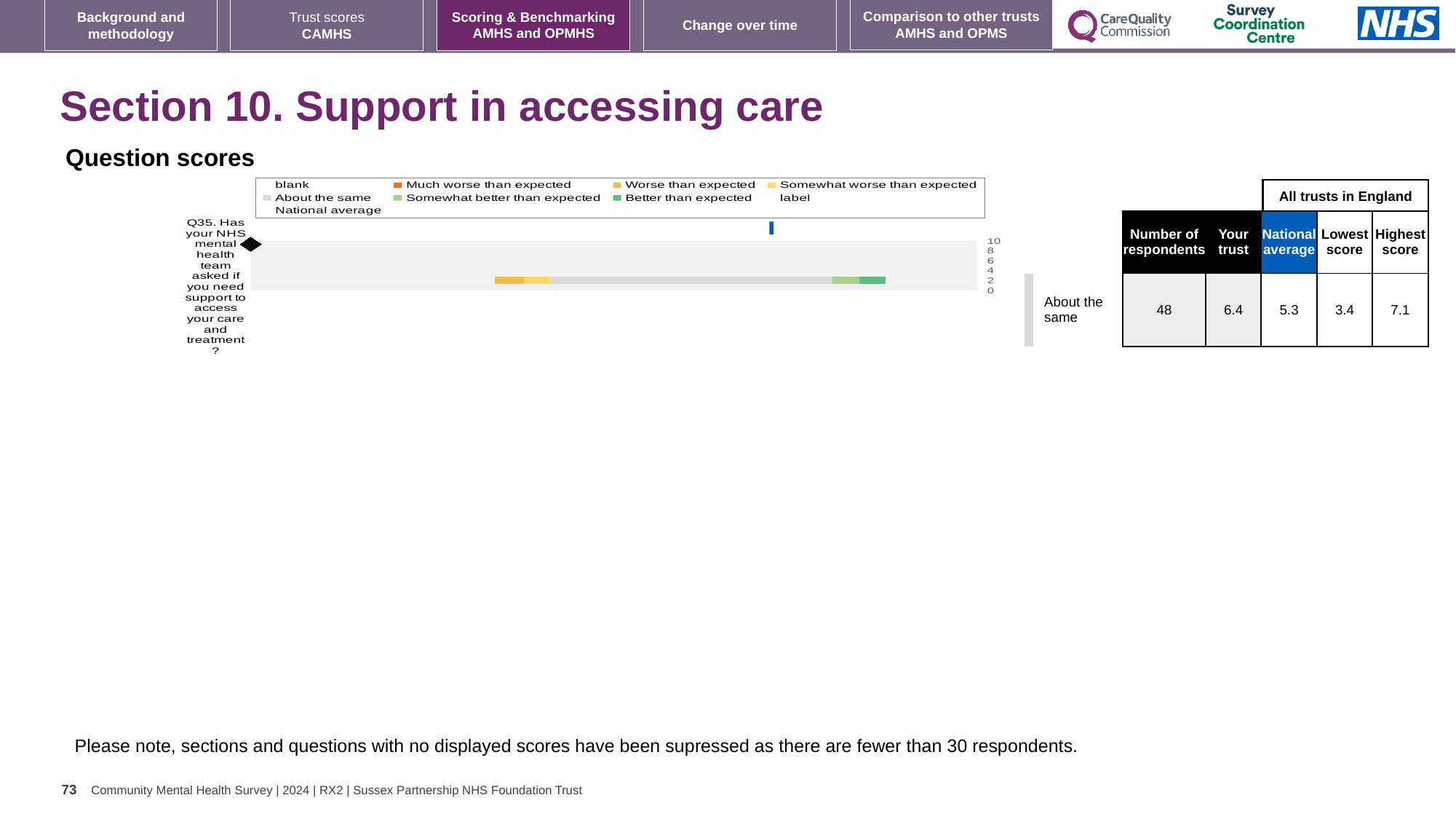
In the table beside the chart, what is the highest score among all trusts in England for Q35? 7.1 What is the highest value shown on the axis of the Question scores chart? 10 How many questions are plotted in the Question scores chart? 1 What is the difference between the 'Your trust' score and the national average for Q35? 1.1 In the table beside the chart, what is the number of respondents for Q35? 48 In the table beside the chart, what is the 'Your trust' score for Q35? 6.4 What is the difference between the highest score (7.1) and the lowest score (3.4) for Q35? 3.7 For Q35, which is larger: the 'Your trust' score or the national average? Your trust In the table beside the chart, what is the lowest score among all trusts in England for Q35? 3.4 Which question is plotted in the Question scores chart? Q35. Has your NHS mental health team asked if you need support to access your care and treatment? What kind of chart is shown under 'Question scores'? bar chart In the table beside the chart, what is the national average score for Q35? 5.3